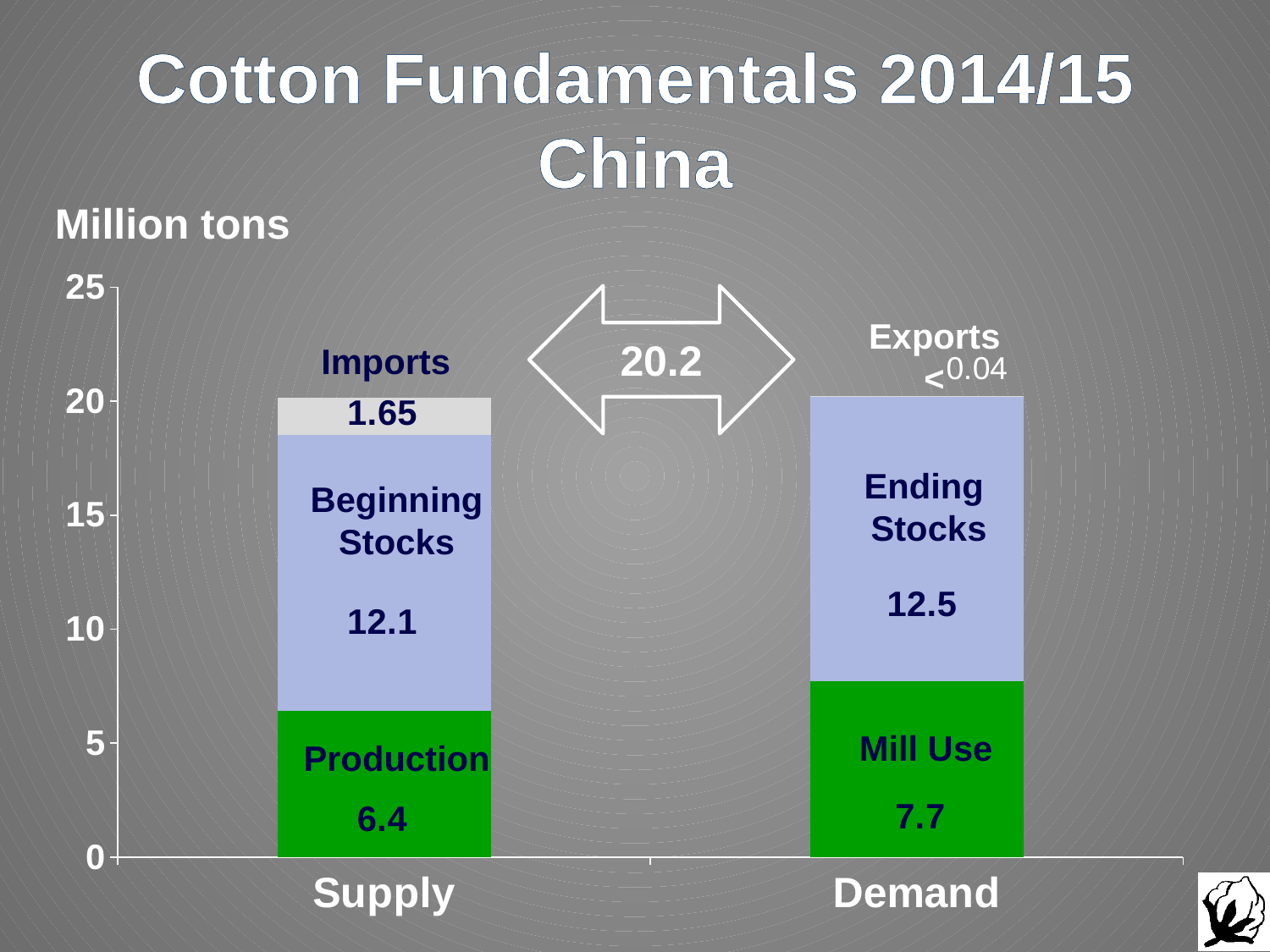
What is the difference between Mill Use and Production? 1.3 What is the value of the Production segment in the Supply bar? 6.4 What value is shown for Exports on the Demand side? <0.04 What is the value of the Imports segment in the Supply bar? 1.65 What kind of chart is shown on the slide? Stacked bar chart Which is larger, Ending Stocks or Beginning Stocks? Ending Stocks What is the value of the Mill Use segment in the Demand bar? 7.7 Which segment of the Supply bar is the largest? Beginning Stocks What is the value of the Beginning Stocks segment in the Supply bar? 12.1 What unit of measurement is stated above the chart? Million tons How many bars are plotted in the chart? 2 What is the value of the Ending Stocks segment in the Demand bar? 12.5